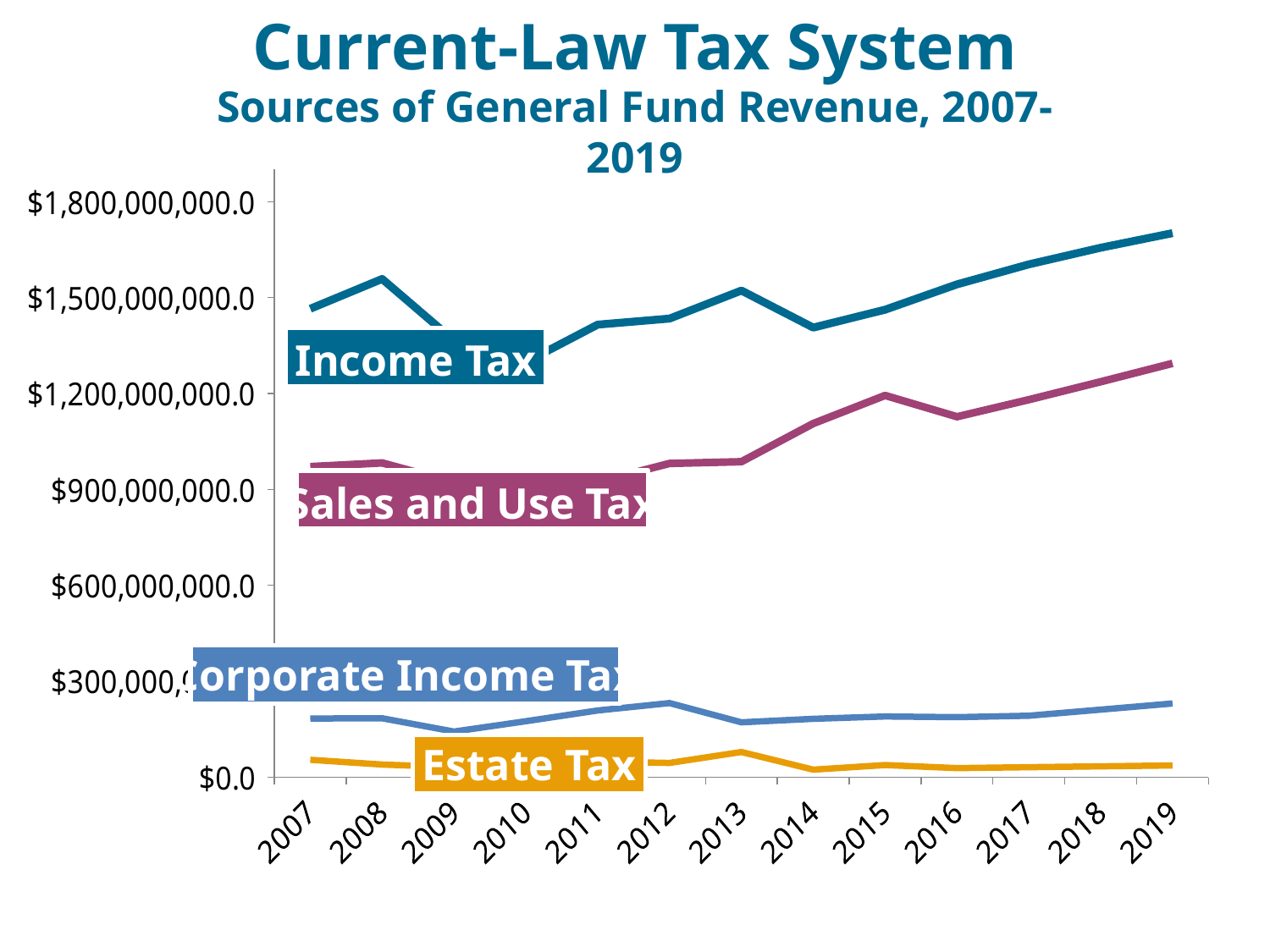
Which is larger in 2007, Sales and Use Tax or Corporate Income Tax? Sales and Use Tax How many years are plotted along the x axis? 13 Is the Income Tax value for 2014 greater or less than $1,500,000,000.0? less Does the Income Tax line rise or fall from 2014 to 2019? rise Which series has the lowest value in 2019? Estate Tax In which year is the Income Tax value highest? 2019 What kind of chart is shown on the slide? line chart Which series has the highest value in 2019? Income Tax Is the Sales and Use Tax value for 2019 greater or less than $1,200,000,000.0? greater How many series are labelled on the chart? 4 In which year is the Estate Tax value highest? 2013 Is the Income Tax value for 2019 greater or less than $1,500,000,000.0? greater